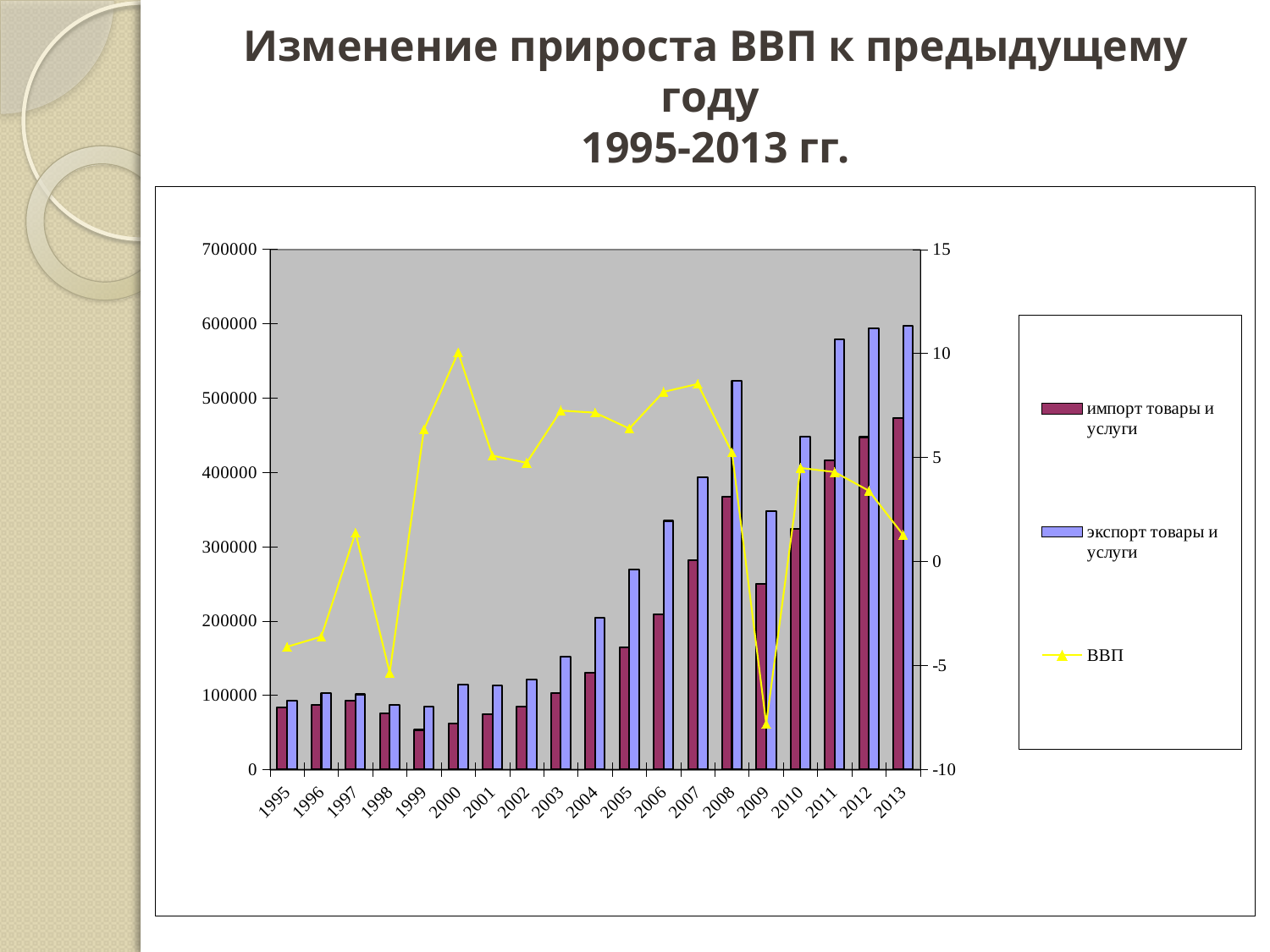
Is the value for импорт товары и услуги in 2009 greater or less than 300000? less In which year is the bar for импорт товары и услуги the lowest? 1999 What colour is the ВВП line in the chart? Yellow How many series does the chart legend list? 3 In 2011, which is larger: импорт товары и услуги or экспорт товары и услуги? экспорт товары и услуги What kind of chart is shown on the slide? A combined bar and line chart In which year does the ВВП line reach its highest point? 2000 In which year is the bar for импорт товары и услуги the highest? 2013 How many years are shown on the x axis of the chart? 19 In which year does the ВВП line reach its lowest point? 2009 Is the ВВП value for 2009 greater or less than -5? less Is the value for экспорт товары и услуги in 2013 greater or less than 500000? greater